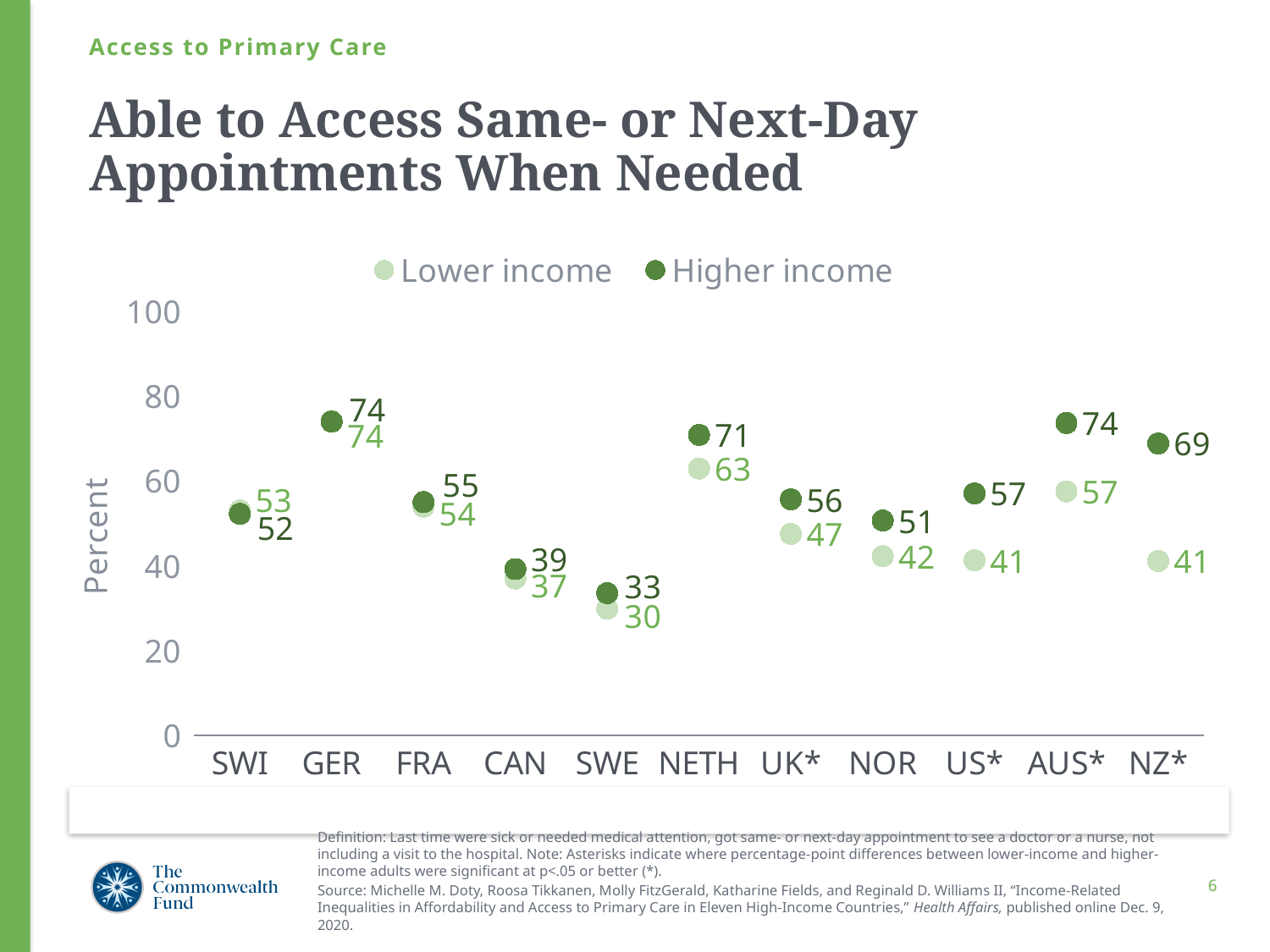
Which country has the lowest Higher income value? SWE How many countries are shown on the x axis? 11 What is the difference between the Higher income and Lower income values for NZ*? 28 What is the Lower income value for SWE? 30 What is the Higher income value for NETH? 71 How many series does the legend list? 2 Which country has the lowest Lower income value? SWE What is the Lower income value for UK*? 47 What is the label on the y axis? Percent What is the Higher income value for NZ*? 69 Which is larger, the Lower income value for NETH or the Lower income value for NOR? NETH What is the difference between the Higher income and Lower income values for AUS*? 17